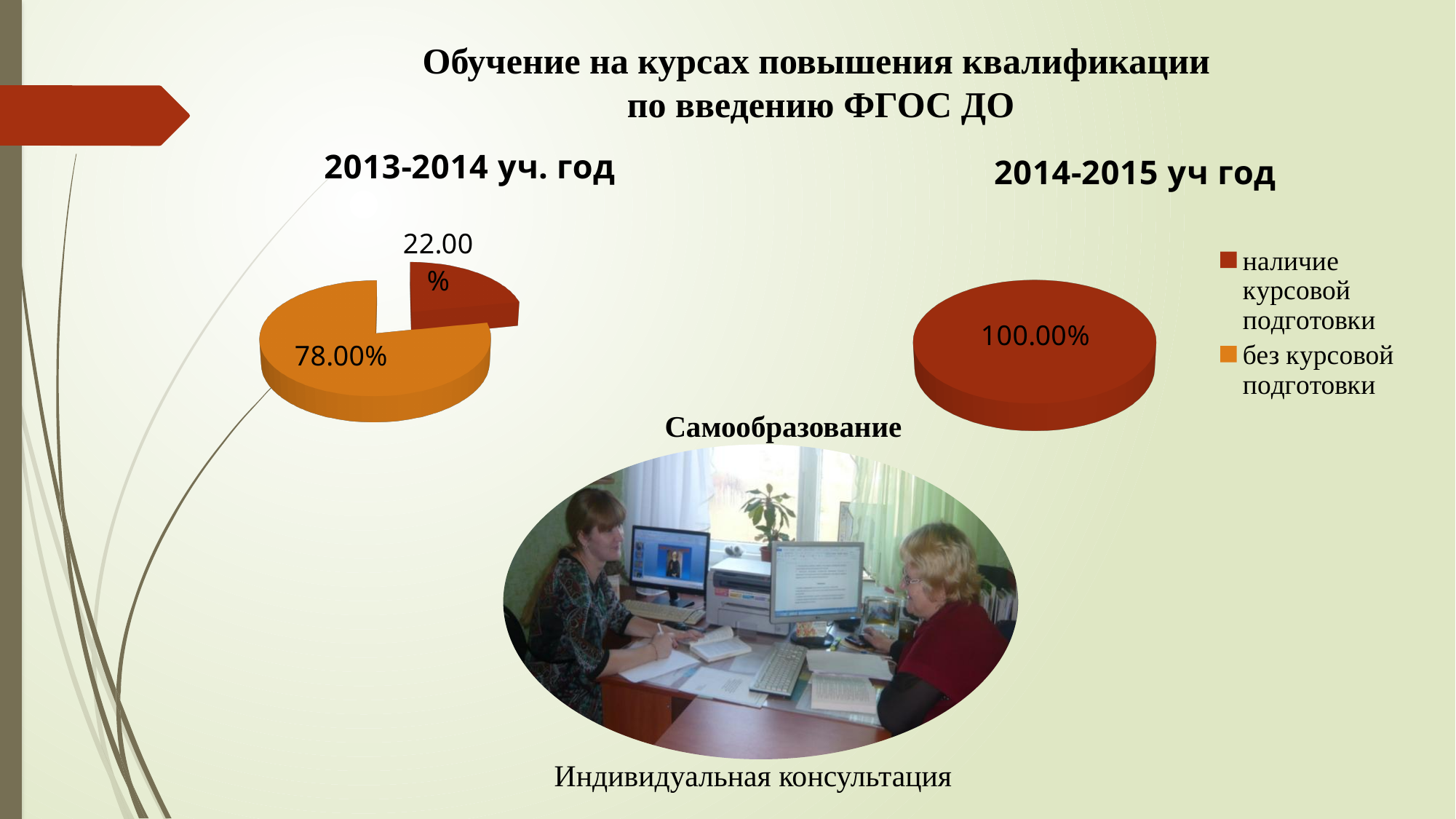
What type of chart is the 2014-2015 уч год chart? Pie chart In the 2013-2014 уч. год chart, which is larger: 'наличие курсовой подготовки' or 'без курсовой подготовки'? без курсовой подготовки In the 2013-2014 уч. год chart, which category has the smallest slice? наличие курсовой подготовки In the 2013-2014 уч. год chart, what share is labelled for the slice 'без курсовой подготовки'? 78.00% How many slices does the 2013-2014 уч. год pie chart have? 2 What type of chart is the 2013-2014 уч. год chart? Pie chart How many entries does the legend list? 2 In the 2014-2015 уч год chart, what value is printed on the pie? 100.00% In the 2013-2014 уч. год chart, what share is labelled for the slice 'наличие курсовой подготовки'? 22.00% In the 2013-2014 уч. год chart, which category has the largest slice? без курсовой подготовки What colour is the 'без курсовой подготовки' slice in the legend? Orange In the 2013-2014 уч. год chart, what is the difference between the 'без курсовой подготовки' and 'наличие курсовой подготовки' shares? 56.00%